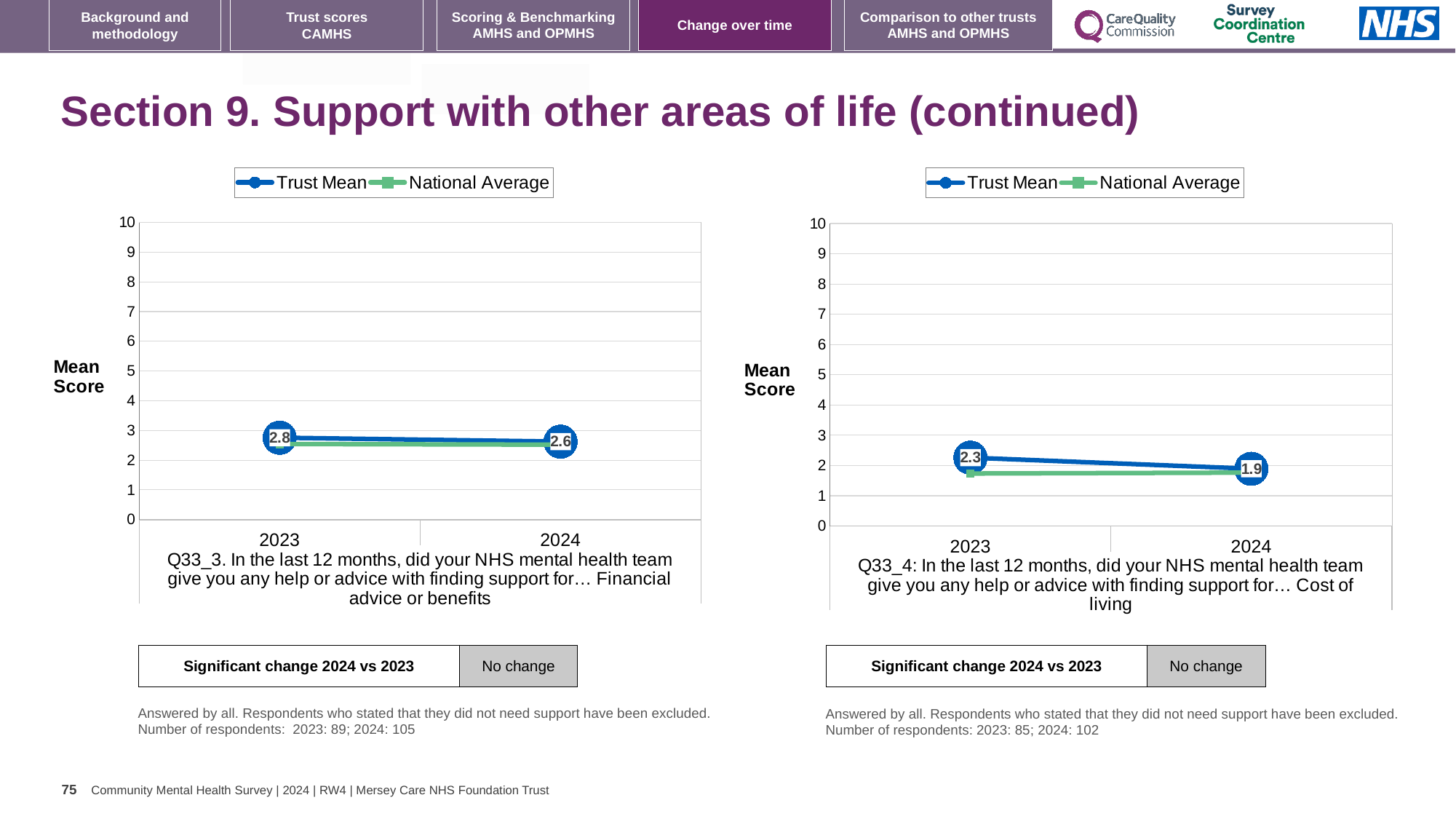
In the left chart (Q33_3), which year has the higher Trust Mean, 2023 or 2024? 2023 In the right chart (Q33_4), does the Trust Mean rise or fall from 2023 to 2024? fall What kind of chart is the left chart (Q33_3)? line chart In the left chart (Q33_3, Financial advice or benefits), what is the Trust Mean for 2024? 2.6 In the right chart (Q33_4), is the National Average for 2023 greater or less than 2? less How many years are plotted on the x axis of the left chart (Q33_3)? 2 In the right chart (Q33_4, Cost of living), what is the Trust Mean for 2024? 1.9 In the right chart (Q33_4, Cost of living), what is the Trust Mean for 2023? 2.3 In the right chart (Q33_4), what is the difference between the Trust Mean for 2023 and 2024? 0.4 In the left chart (Q33_3, Financial advice or benefits), what is the Trust Mean for 2023? 2.8 In the left chart (Q33_3), by how much did the Trust Mean change from 2023 to 2024? 0.2 How many series does the legend of the right chart (Q33_4) list? 2